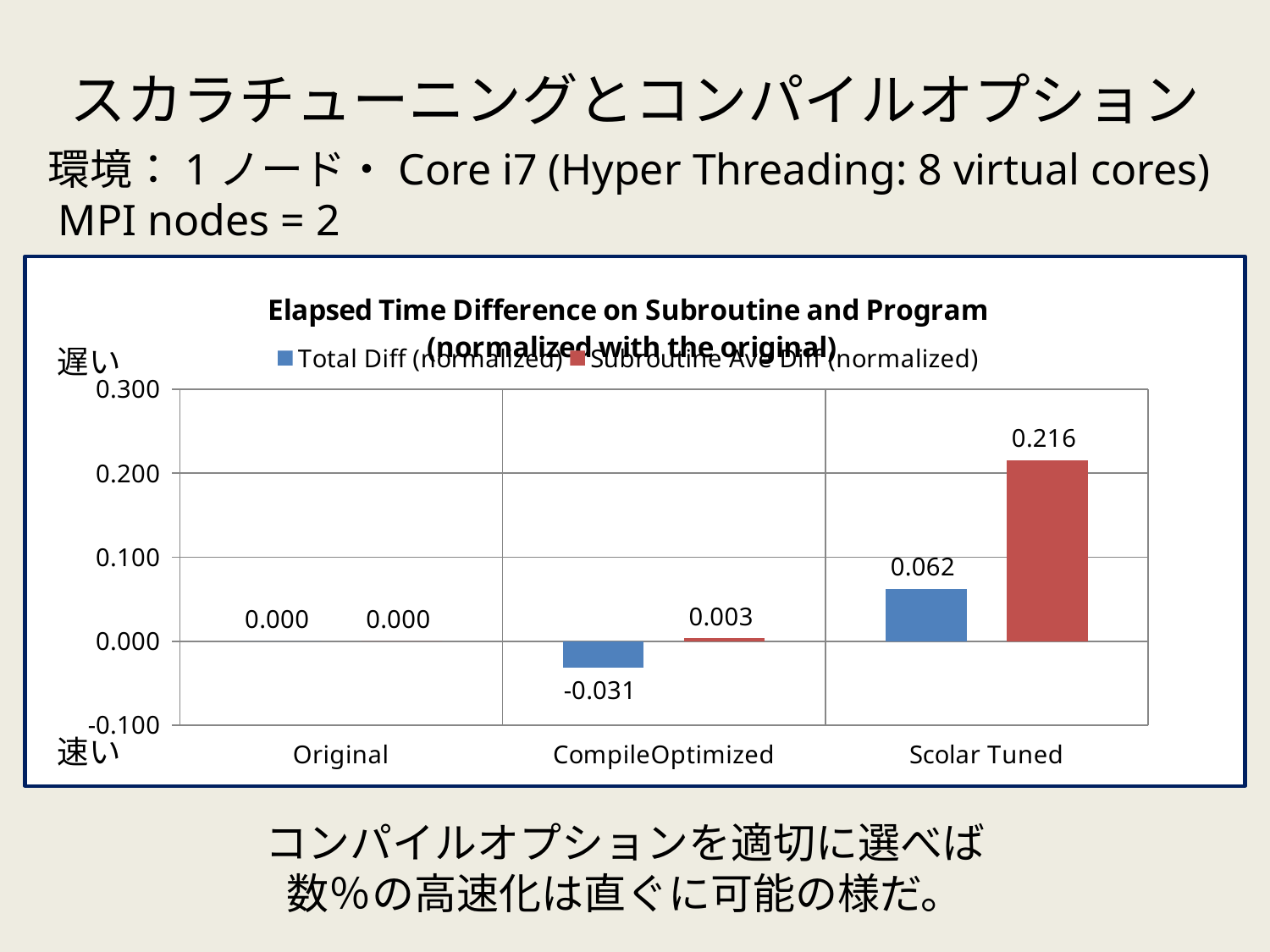
Which category has the highest Subroutine Ave Diff (normalized) value? Scolar Tuned What is the Total Diff (normalized) value for Scolar Tuned? 0.062 Which category has the lowest Total Diff (normalized) value? CompileOptimized What is the Subroutine Ave Diff (normalized) value for CompileOptimized? 0.003 For CompileOptimized, which is larger: Total Diff (normalized) or Subroutine Ave Diff (normalized)? Subroutine Ave Diff (normalized) How many categories are shown on the x axis? 3 Is the Subroutine Ave Diff (normalized) value for Scolar Tuned greater or less than 0.200? greater What kind of chart is shown on the slide? bar chart What is the Total Diff (normalized) value for CompileOptimized? -0.031 How many series does the legend list? 2 What is the difference between the Subroutine Ave Diff (normalized) and Total Diff (normalized) values for Scolar Tuned? 0.154 What is the Subroutine Ave Diff (normalized) value for Scolar Tuned? 0.216